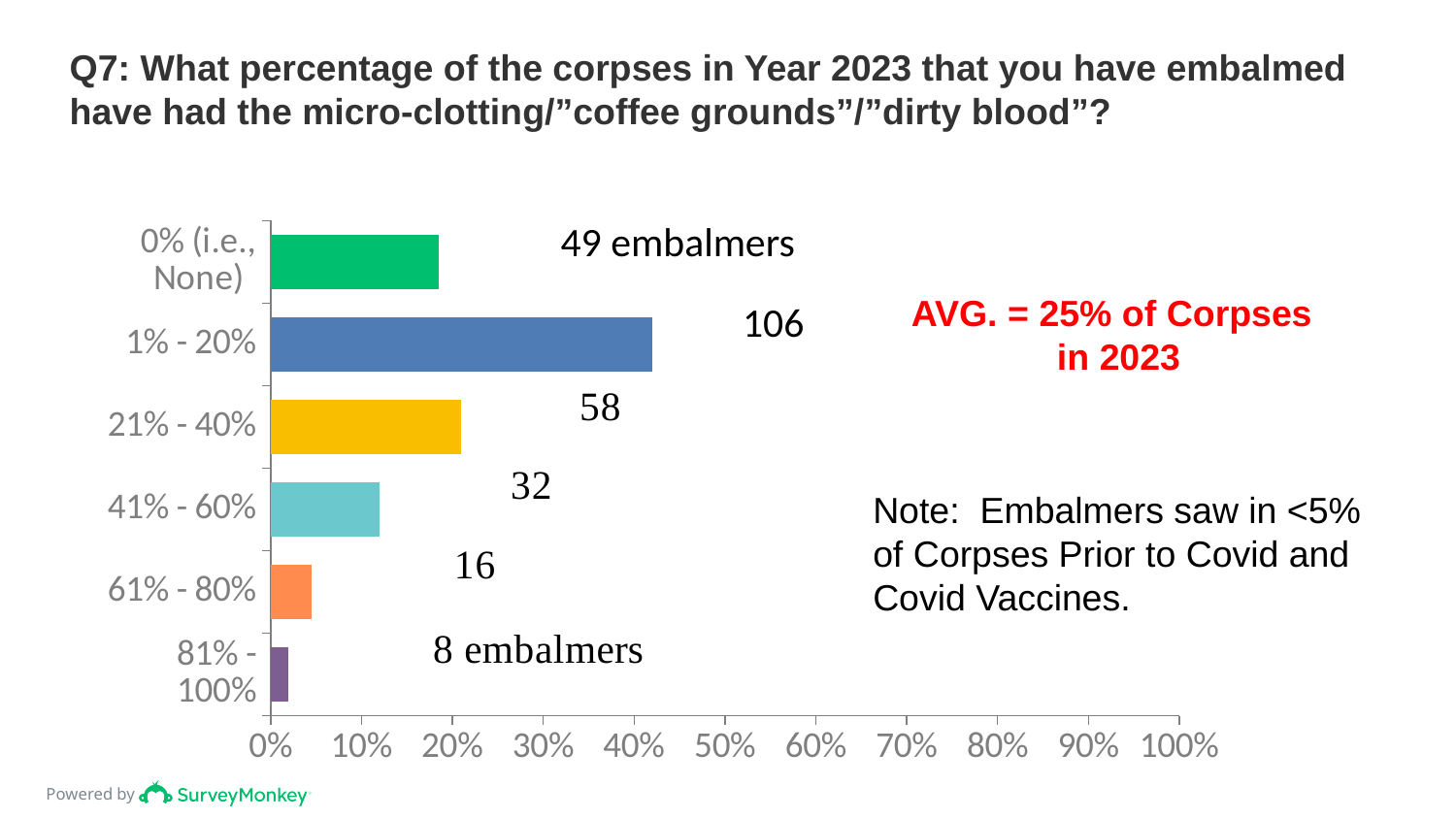
Which category has the longest bar? 1% - 20% What is the difference between the number of embalmers in the 1% - 20% category and the 21% - 40% category? 48 Is the bar for the 41% - 60% category greater or less than 20%? less How many embalmers are labelled for the 41% - 60% category? 32 What type of chart is shown on the slide? bar chart How many embalmers are labelled for the 81% - 100% category? 8 embalmers How many categories are shown on the chart? 6 How many embalmers are labelled for the 1% - 20% category? 106 How many embalmers are labelled for the 21% - 40% category? 58 Which category has the shortest bar? 81% - 100% Is the bar for the 1% - 20% category greater or less than 30%? greater Which category has more embalmers, 0% (i.e., None) or 21% - 40%? 21% - 40%